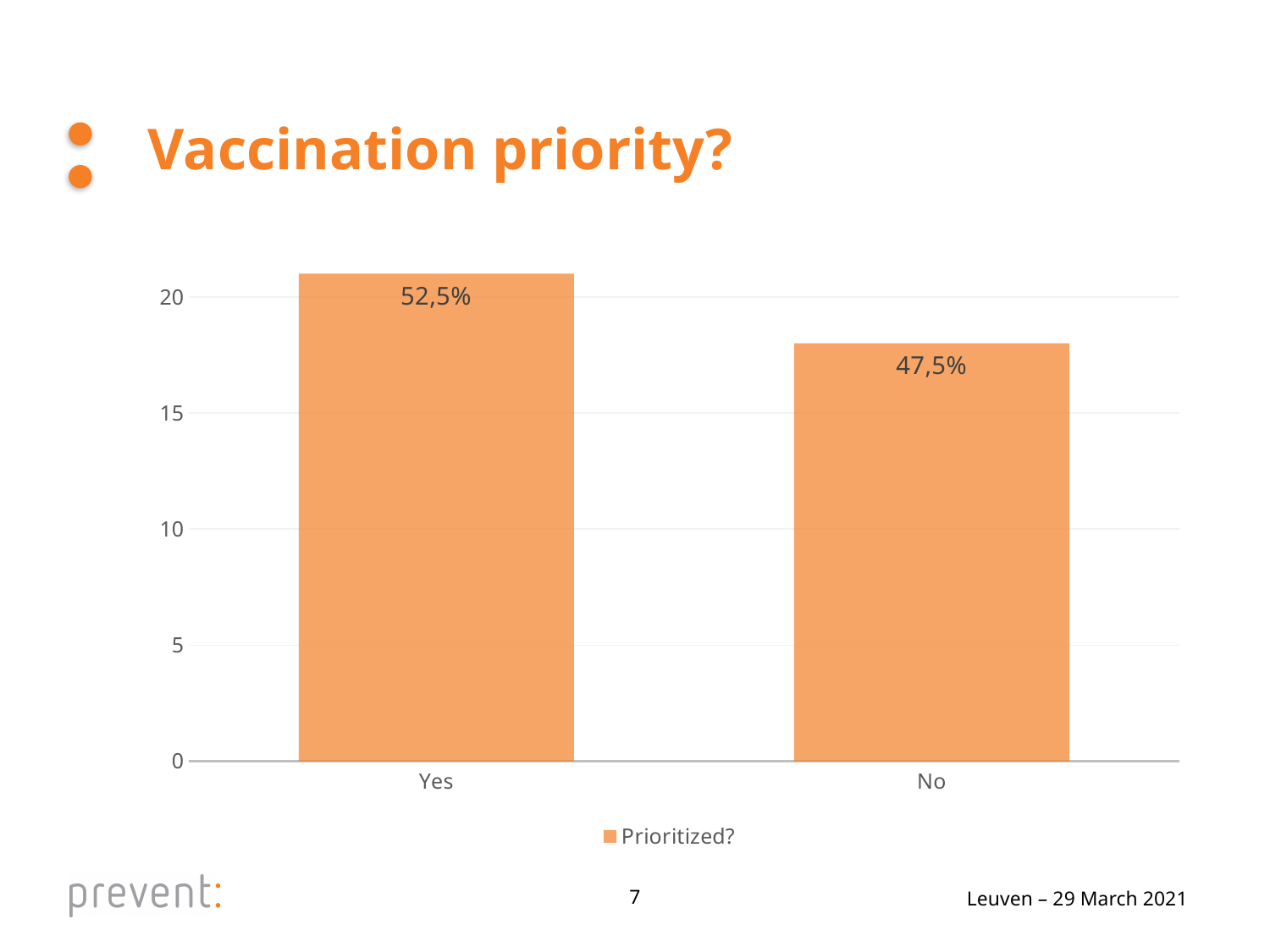
Is the height of the No bar greater or less than 20 on the vertical axis? less Is the height of the Yes bar greater or less than 20 on the vertical axis? greater Which category has the lowest value? No How many categories are shown on the x axis? 2 What is the legend entry for the series? Prioritized? What is the data label on the No bar? 47,5% What is the data label on the Yes bar? 52,5% By how many percentage points does the Yes label exceed the No label? 5 Which category has the higher bar, Yes or No? Yes Which category has the highest value? Yes How many series does the legend list? 1 What type of chart is shown on the slide? bar chart